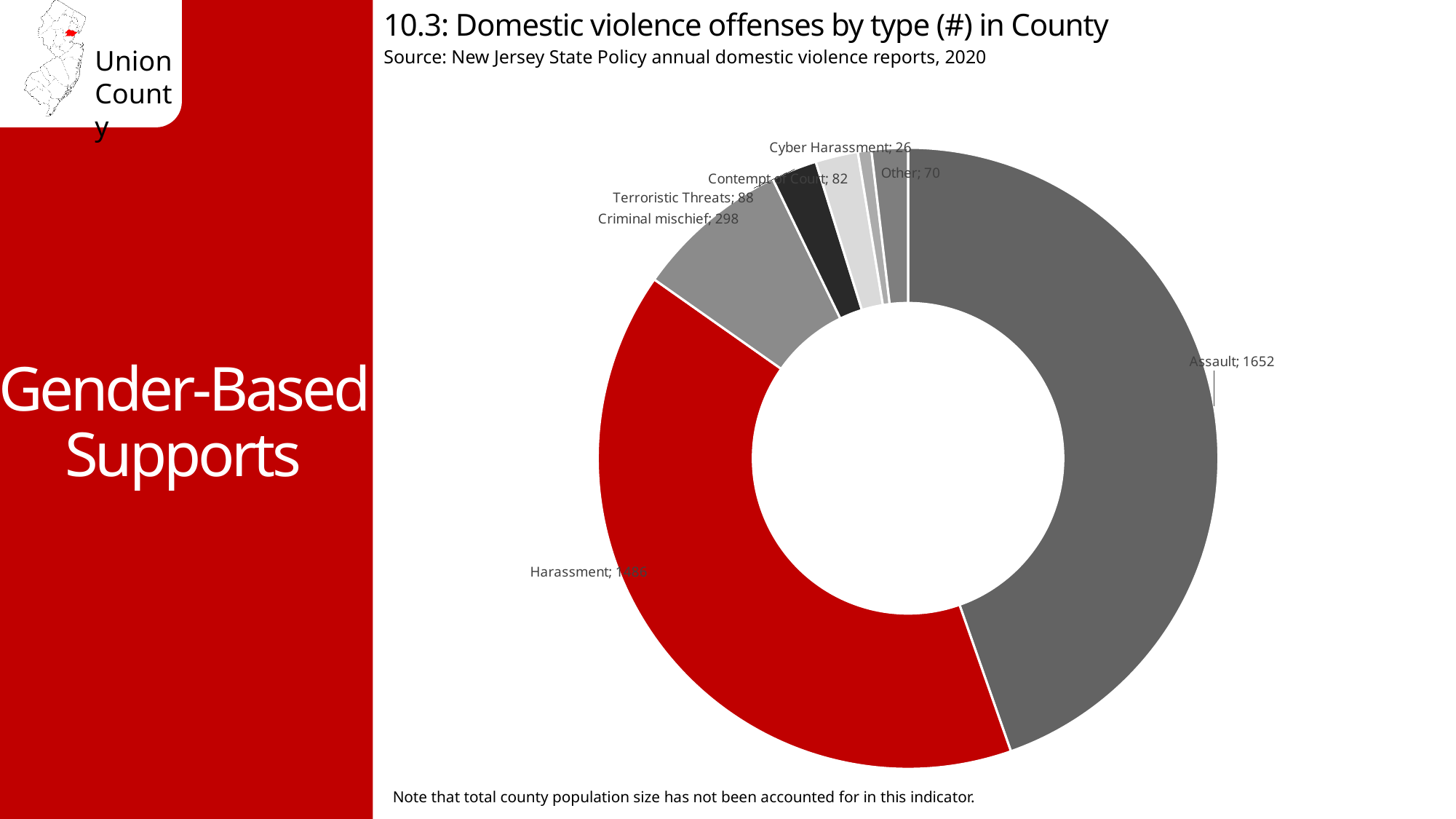
Which is larger, the value for Other or the value for Cyber Harassment? Other What is the difference between the Criminal mischief and Terroristic Threats values? 210 How many Criminal mischief offenses are shown in the chart? 298 What is the number of Assault offenses shown in the chart? 1652 Which offense type has the smallest number of offenses? Cyber Harassment What value is shown for Cyber Harassment? 26 What kind of chart is used on this slide? doughnut chart How many offense categories are shown in the chart? 7 What value is shown for the Other category? 70 Which offense type has the largest number of offenses? Assault What value is shown for Terroristic Threats? 88 What value is shown for Contempt of Court? 82